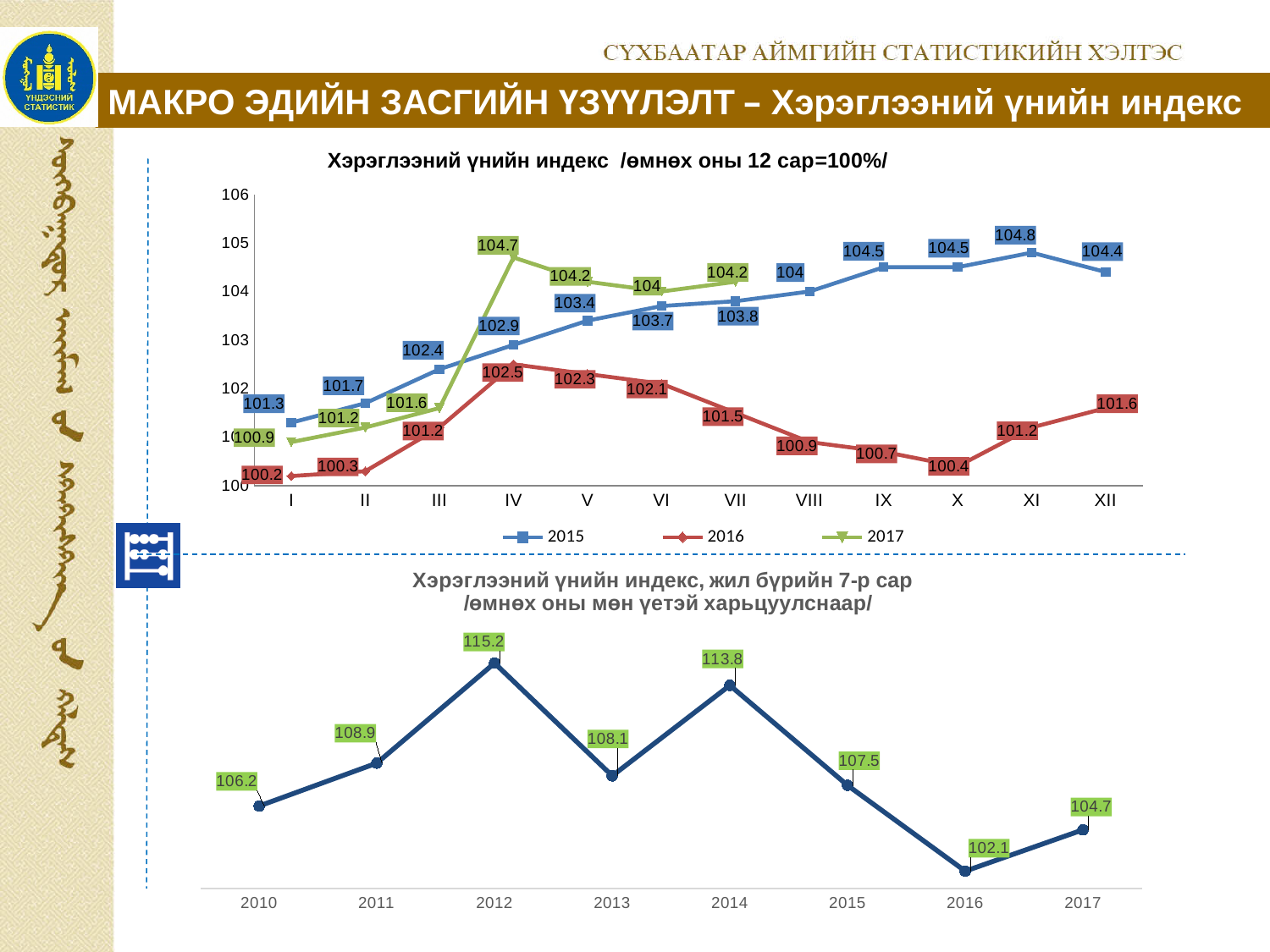
In the bottom chart, what is the difference between the 2014 and 2015 values? 6.3 In the top chart, what is the difference between the 2015 and 2016 values in month X? 4.1 What kind of chart is the bottom chart? Line chart In the top chart, how many series does the legend list? 3 In the top chart, which is larger in month IV: the 2017 value or the 2015 value? 2017 In the bottom chart, how many years are plotted? 8 In the top chart, what is the value for 2017 in month VII? 104.2 In the top chart, what is the value for 2016 in month IV? 102.5 In the top chart, which month has the lowest value for the 2016 series? I In the top chart, what is the value for 2015 in month XI? 104.8 In the bottom chart, which year has the highest value? 2012 In the bottom chart, what is the value for 2016? 102.1